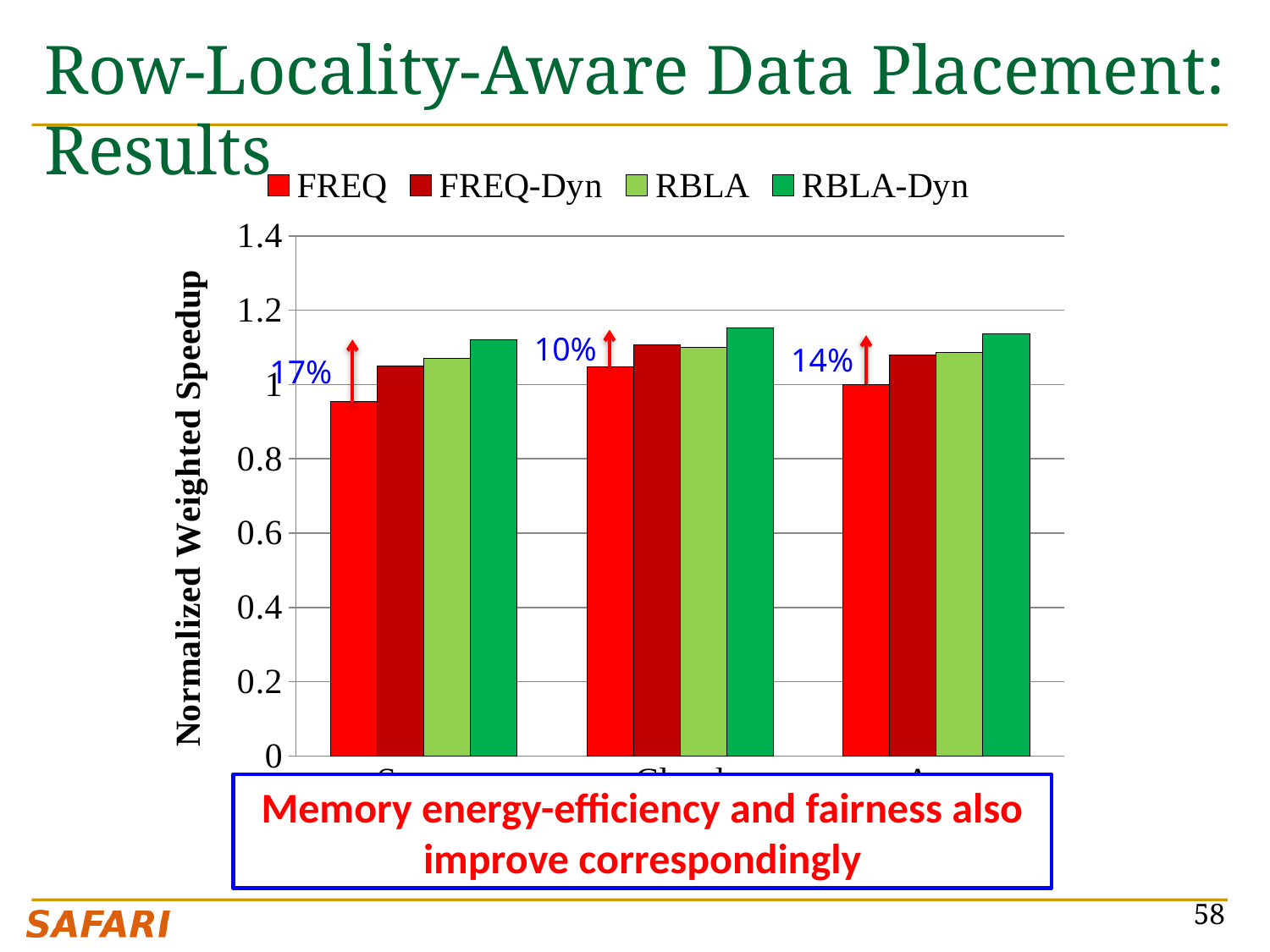
What percentage improvement is annotated above the first (leftmost) group of bars? 17% In the middle group, which is larger, FREQ or RBLA-Dyn? RBLA-Dyn How many groups of bars are plotted along the x axis? 3 What percentage improvement is annotated above the third (rightmost) group of bars? 14% Is the RBLA-Dyn value in the leftmost group greater or less than 1? greater What percentage improvement is annotated above the middle group of bars? 10% In the leftmost group, which series has the highest bar? RBLA-Dyn What is the title of the y axis? Normalized Weighted Speedup Which series is listed first in the legend? FREQ How many series does the legend list? 4 Is the FREQ value in the leftmost group greater or less than 1? less What kind of chart is shown on the slide? bar chart